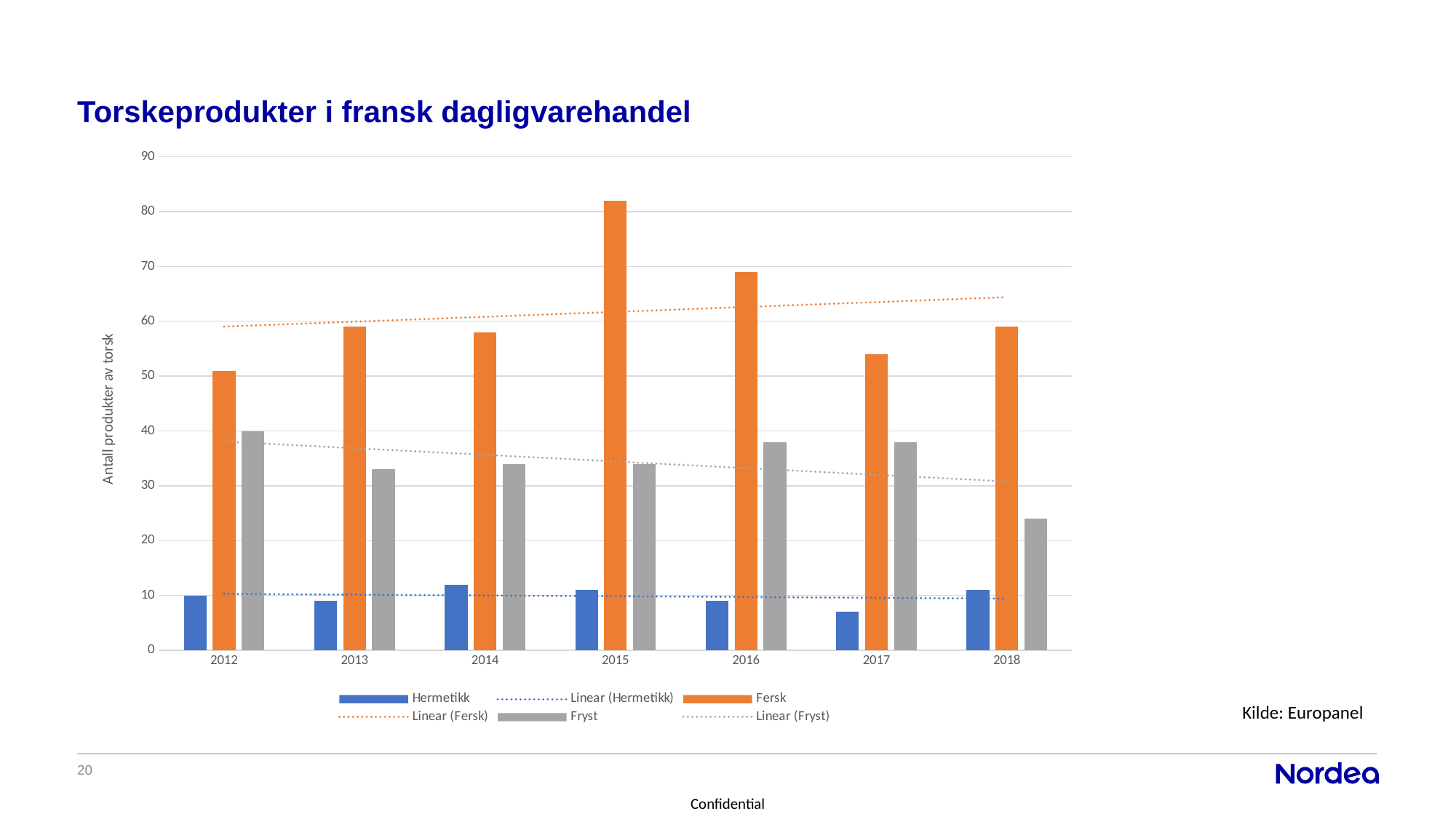
How many entries does the chart's legend list? 6 In which year is the Fryst bar lowest? 2018 In which year is the Fersk bar highest? 2015 In 2016, which is larger, Fersk or Fryst? Fersk What is the value for Fryst in 2012? 40 What is the title of the chart's vertical axis? Antall produkter av torsk Is the value for Fryst in 2018 greater or less than 30? less What kind of chart is shown on the slide? Bar chart Does the Linear (Fryst) trend line rise or fall from 2012 to 2018? Fall Is the value for Fersk in 2015 greater or less than 80? greater Is the value for Hermetikk in 2017 greater or less than 10? less How many years are shown on the x axis of the chart? 7